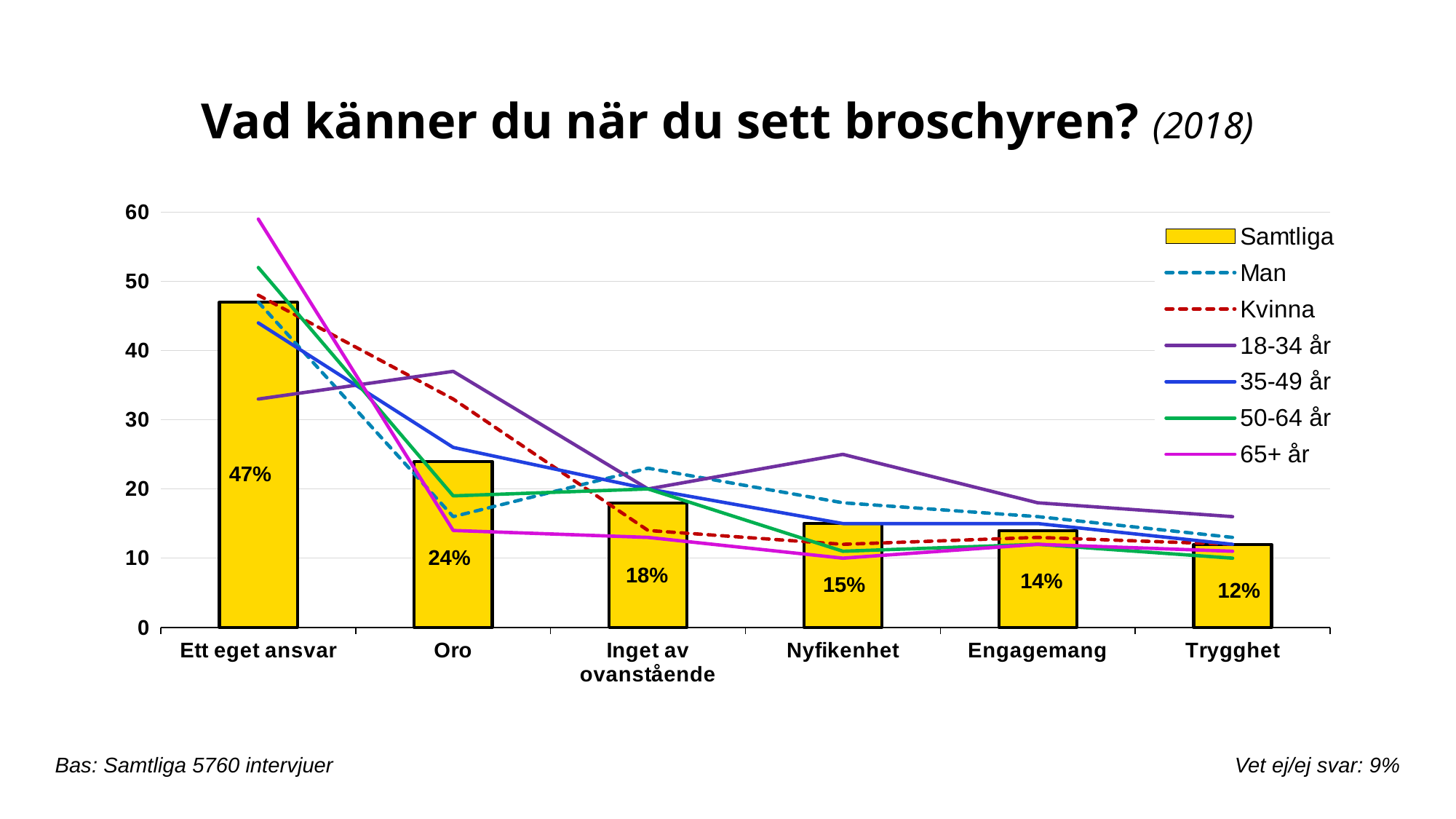
Which category has the highest Samtliga value? Ett eget ansvar What is the difference between the Samtliga values for Ett eget ansvar and Oro? 23 percentage points Do the Samtliga bar values rise or fall from left to right along the x axis? fall How many series does the legend list? 7 What is the Samtliga value for Oro? 24% How many categories are shown on the x axis? 6 What is the Samtliga value for Nyfikenhet? 15% Which category has the lowest Samtliga value? Trygghet Is the value for 65+ år at Ett eget ansvar greater or less than 50? greater Is the value for 18-34 år at Ett eget ansvar greater or less than 40? less Which has the larger Samtliga value, Inget av ovanstående or Engagemang? Inget av ovanstående What kind of chart is this? A combined bar and line chart